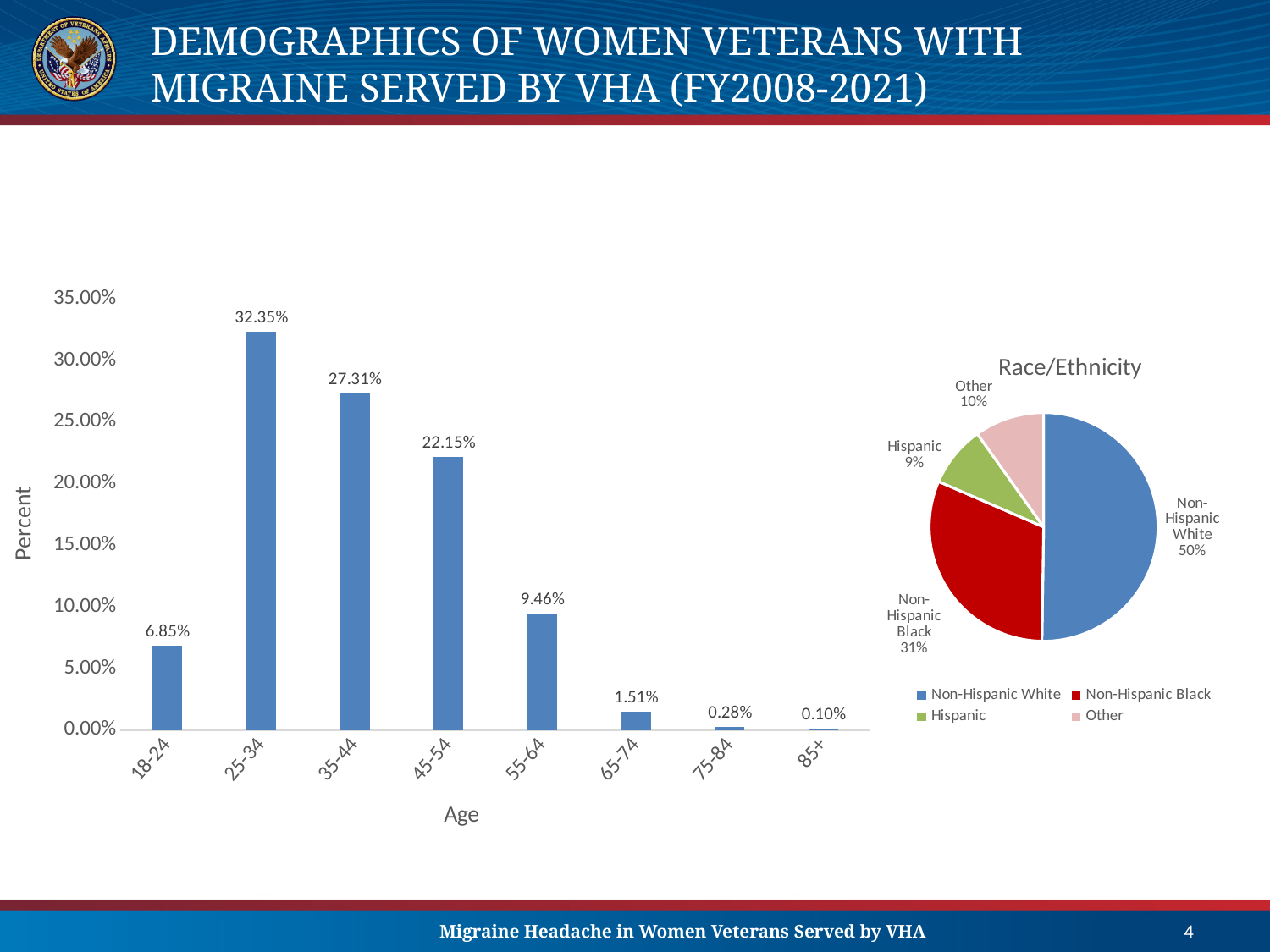
In the Age bar chart, which is larger, the value for 18-24 or the value for 55-64? 55-64 In the Age bar chart, which age group has the lowest percentage? 85+ What kind of chart is the chart on the left showing percentages by age? Bar chart In the Age bar chart, do the values rise or fall from 25-34 to 85+? Fall In the Race/Ethnicity pie chart, what share is Non-Hispanic Black? 31% In the Age bar chart, what is the value for the 55-64 age group? 9.46% In the Race/Ethnicity pie chart, which category has the largest slice? Non-Hispanic White How many age groups are shown in the Age bar chart? 8 How many entries does the legend of the Race/Ethnicity pie chart list? 4 In the Age bar chart, what is the value for the 25-34 age group? 32.35% In the Age bar chart, which age group has the highest percentage? 25-34 In the Age bar chart, what is the difference between the values for 35-44 and 45-54? 5.16%